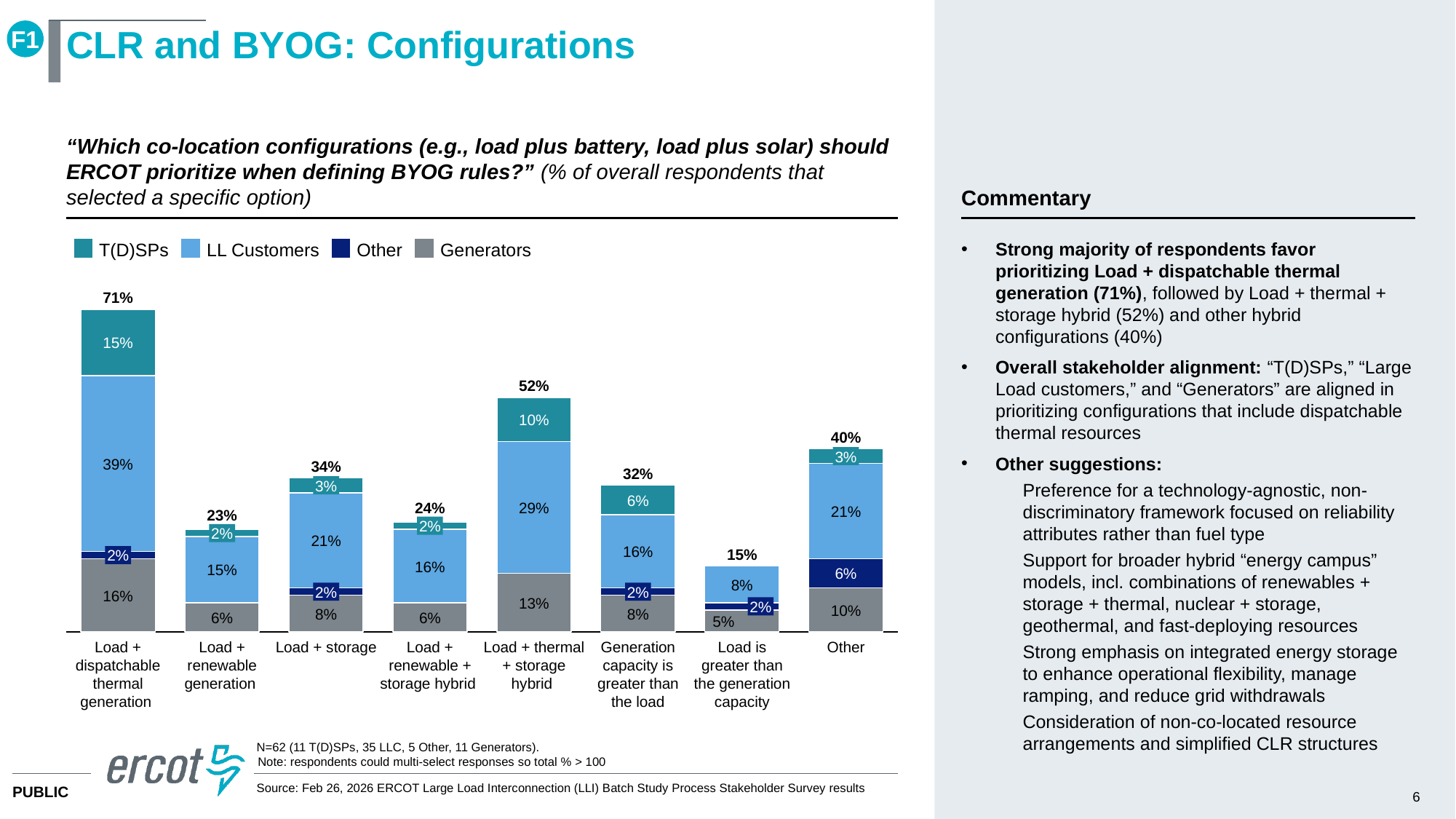
How many configuration categories are shown on the x axis? 8 Which configuration has the highest total percentage? Load + dispatchable thermal generation What is the LL Customers value for Load + thermal + storage hybrid? 29% What is the Generators value for Load + dispatchable thermal generation? 16% Which has a larger total: Other or Generation capacity is greater than the load? Other Which configuration has the lowest total percentage? Load is greater than the generation capacity What is the T(D)SPs value for Generation capacity is greater than the load? 6% What kind of chart is shown on the slide? Stacked bar chart What is the difference between the total for Load + thermal + storage hybrid and the total for Load + storage? 18% What is the total percentage for Load + dispatchable thermal generation? 71% How many series does the legend list? 4 Which series is shown in gray in the legend? Generators